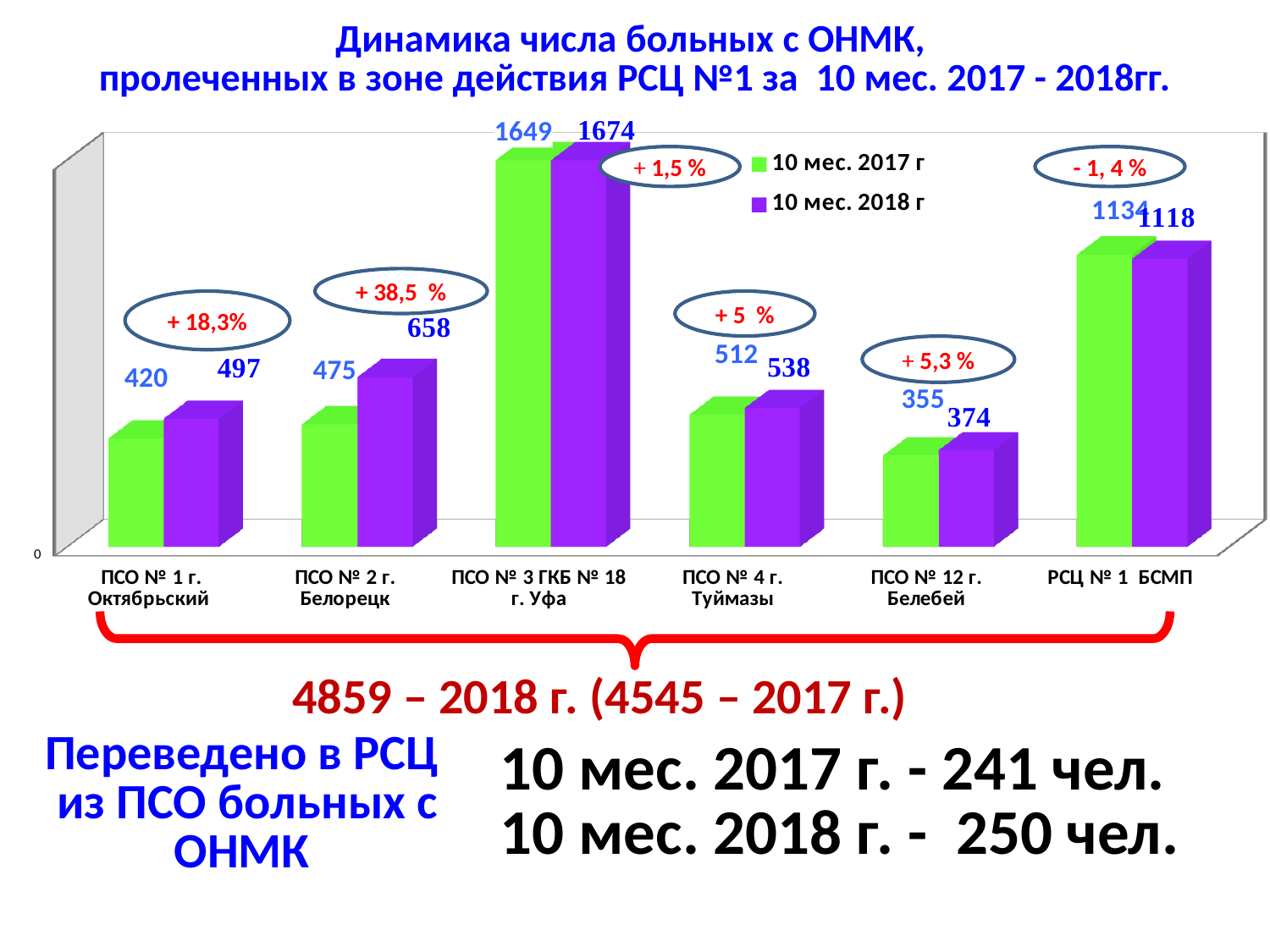
What is the value for ПСО № 2 г. Белорецк in the series 10 мес. 2018 г? 658 What is the value for РСЦ № 1 БСМП in the series 10 мес. 2018 г? 1118 How many categories are shown on the x axis? 6 For РСЦ № 1 БСМП, which series has the larger value: 10 мес. 2017 г or 10 мес. 2018 г? 10 мес. 2017 г What is the difference between the 10 мес. 2018 г and 10 мес. 2017 г values for ПСО № 3 ГКБ № 18 г. Уфа? 25 Which colour represents the series 10 мес. 2018 г in the legend? purple Which category has the highest value in the series 10 мес. 2017 г? ПСО № 3 ГКБ № 18 г. Уфа What is the difference between the 10 мес. 2018 г and 10 мес. 2017 г values for ПСО № 1 г. Октябрьский? 77 Which category has the lowest value in the series 10 мес. 2018 г? ПСО № 12 г. Белебей What type of chart is shown on the slide? bar chart What is the value for ПСО № 12 г. Белебей in the series 10 мес. 2017 г? 355 How many series does the legend list? 2